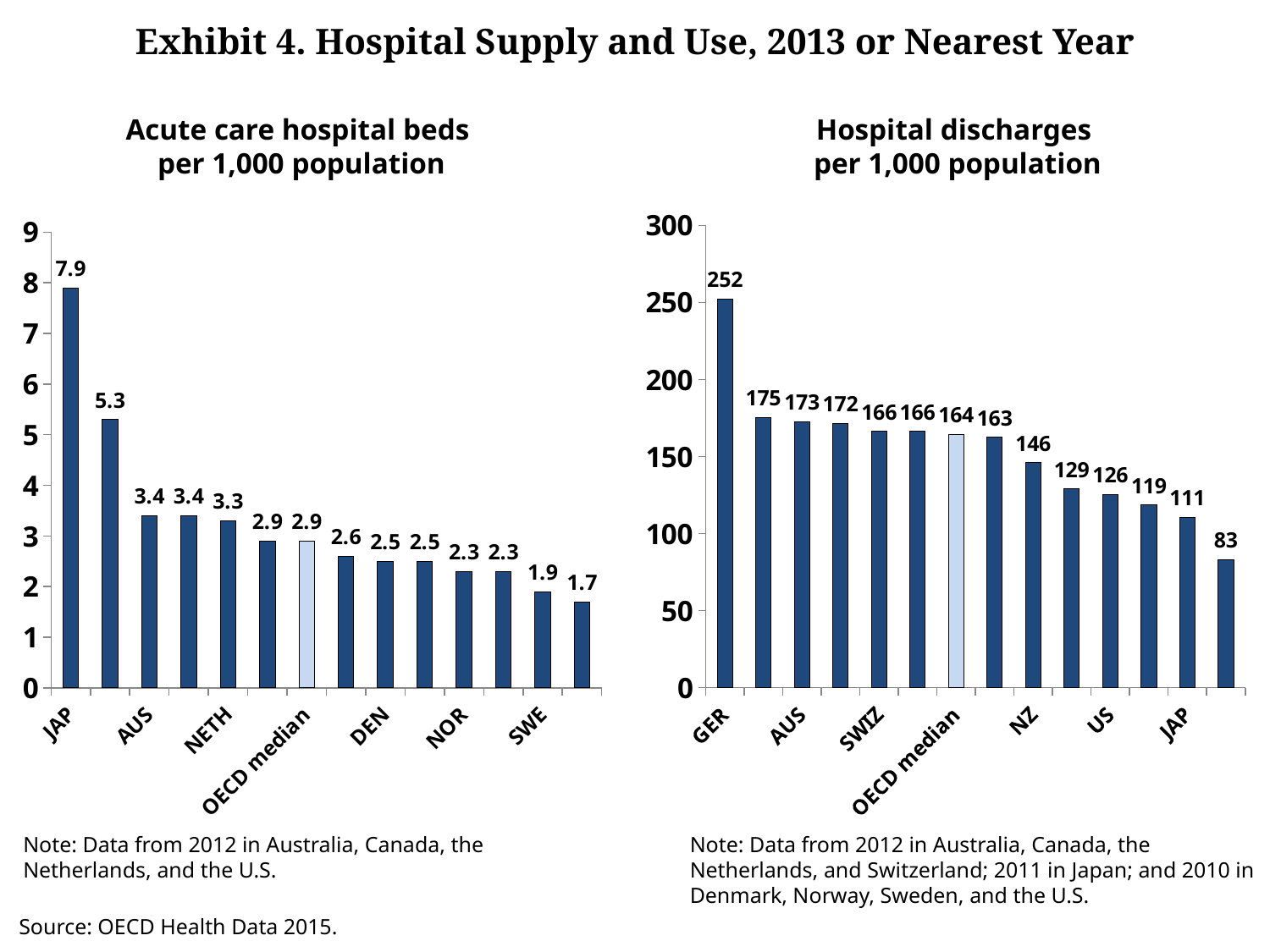
In the 'Hospital discharges per 1,000 population' chart, what is the difference between GER and JAP? 141 In the 'Hospital discharges per 1,000 population' chart, what is the value for JAP? 111 In the 'Hospital discharges per 1,000 population' chart, what is the value for GER? 252 What type of chart is the 'Hospital discharges per 1,000 population' chart? Bar chart In the 'Acute care hospital beds per 1,000 population' chart, what is the value for SWE? 1.9 In the 'Acute care hospital beds per 1,000 population' chart, what is the value for the OECD median? 2.9 How many bars are plotted in the 'Acute care hospital beds per 1,000 population' chart? 14 In the 'Hospital discharges per 1,000 population' chart, which is larger, NZ or US? NZ In the 'Hospital discharges per 1,000 population' chart, what is the value for the OECD median? 164 In the 'Acute care hospital beds per 1,000 population' chart, what is the difference between JAP and AUS? 4.5 In the 'Acute care hospital beds per 1,000 population' chart, what is the value for JAP? 7.9 In the 'Acute care hospital beds per 1,000 population' chart, which country has the highest value? JAP